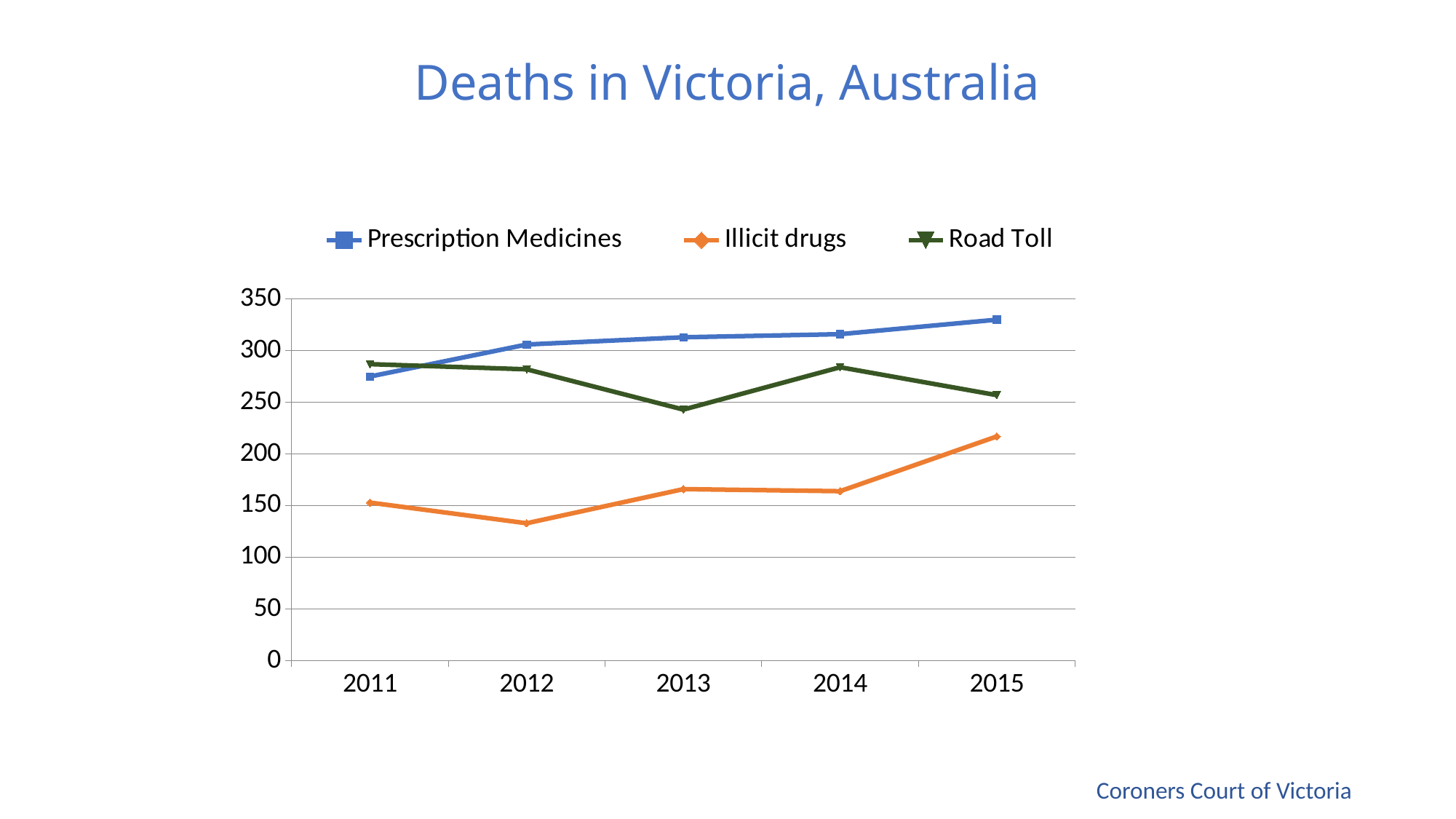
Do the Prescription Medicines values rise or fall from 2011 to 2015? Rise How many years are plotted along the x axis? 5 Is the value for Road Toll in 2013 greater or less than 250? less Is the value for Illicit drugs in 2012 greater or less than 150? less What is the title of the chart? Deaths in Victoria, Australia In which year is the Illicit drugs value highest? 2015 Is the value for Prescription Medicines in 2015 greater or less than 300? greater What kind of chart is shown on the slide? Line chart How many series does the legend list? 3 In which year is the Road Toll value lowest? 2013 In 2011, which is higher: Road Toll or Prescription Medicines? Road Toll In which year is the Illicit drugs value lowest? 2012